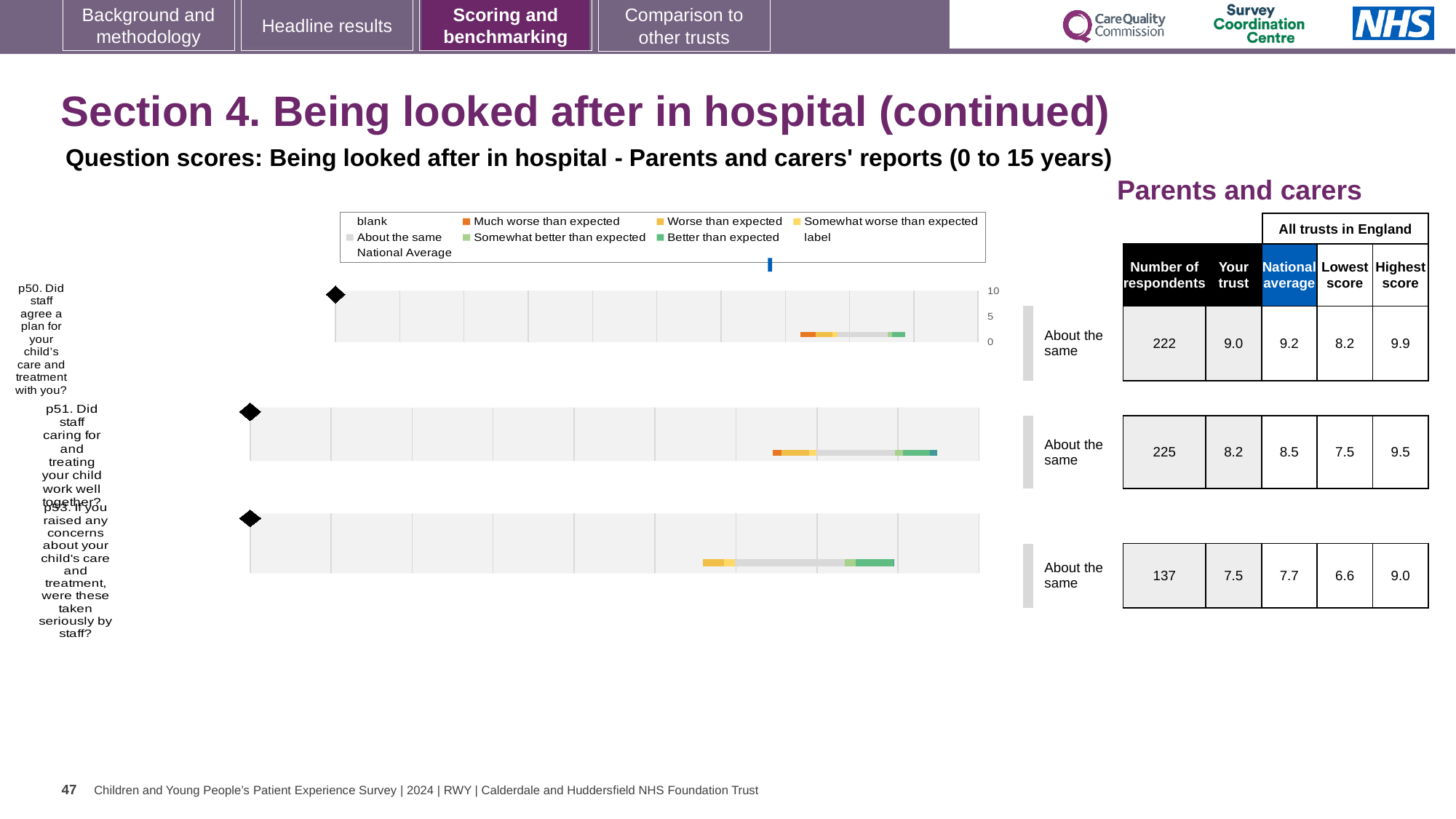
How many questions (p50, p51, p53) have a benchmark bar chart on this slide? 3 What colour does the legend use for 'Much worse than expected'? Orange What is the 'Your trust' score for p50 (Did staff agree a plan for your child's care and treatment with you?)? 9.0 Which question has the lowest 'Highest score' across all trusts in England? p53 What benchmark category is shown next to the chart for p51? About the same How many respondents answered p53 (If you raised any concerns about your child's care and treatment, were these taken seriously by staff?)? 137 What kind of chart is used to show the question scores for p50, p51 and p53? bar chart For p50, what is the difference between the highest score and the lowest score across all trusts in England? 1.7 For p53, how much higher is the national average than the 'Your trust' score? 0.2 For p51, which is larger: the 'Your trust' score or the national average? National average Which question has the highest 'Your trust' score? p50 What is the national average score for p51 (Did staff caring for and treating your child work well together?)? 8.5